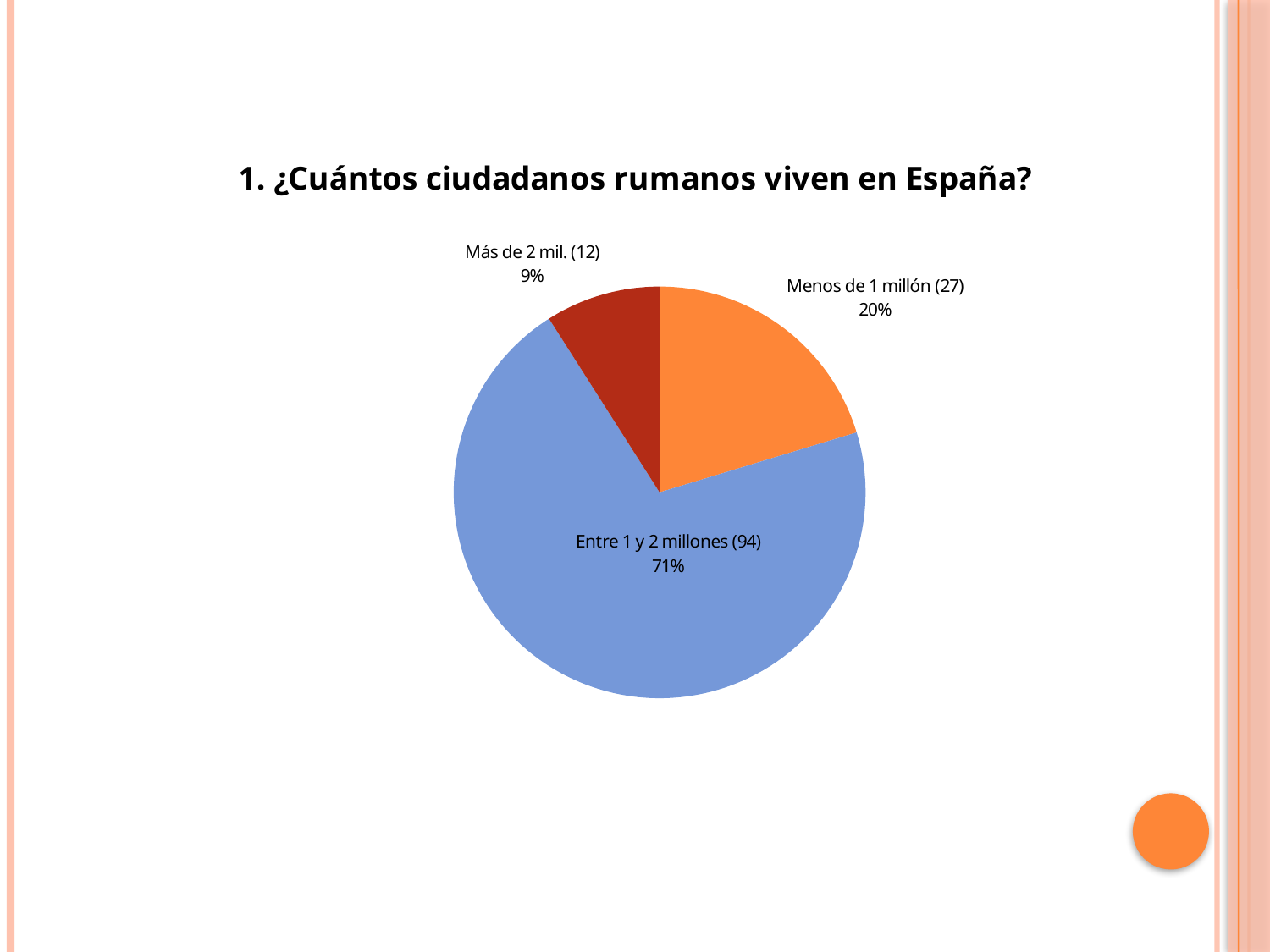
How many slices does the pie chart have? 3 What is the difference in responses between 'Menos de 1 millón' and 'Más de 2 mil.'? 15 What percentage share does the slice 'Entre 1 y 2 millones' have? 71% What is the title of the chart? 1. ¿Cuántos ciudadanos rumanos viven en España? How many responses are shown in parentheses for 'Menos de 1 millón'? 27 What kind of chart is shown on the slide? pie chart What percentage share does the slice 'Más de 2 mil.' have? 9% What percentage share does the slice 'Menos de 1 millón' have? 20% How many responses are shown in parentheses for 'Más de 2 mil.'? 12 Which category has the smallest slice of the pie? Más de 2 mil. Which category has the largest slice of the pie? Entre 1 y 2 millones How many responses are shown in parentheses for 'Entre 1 y 2 millones'? 94